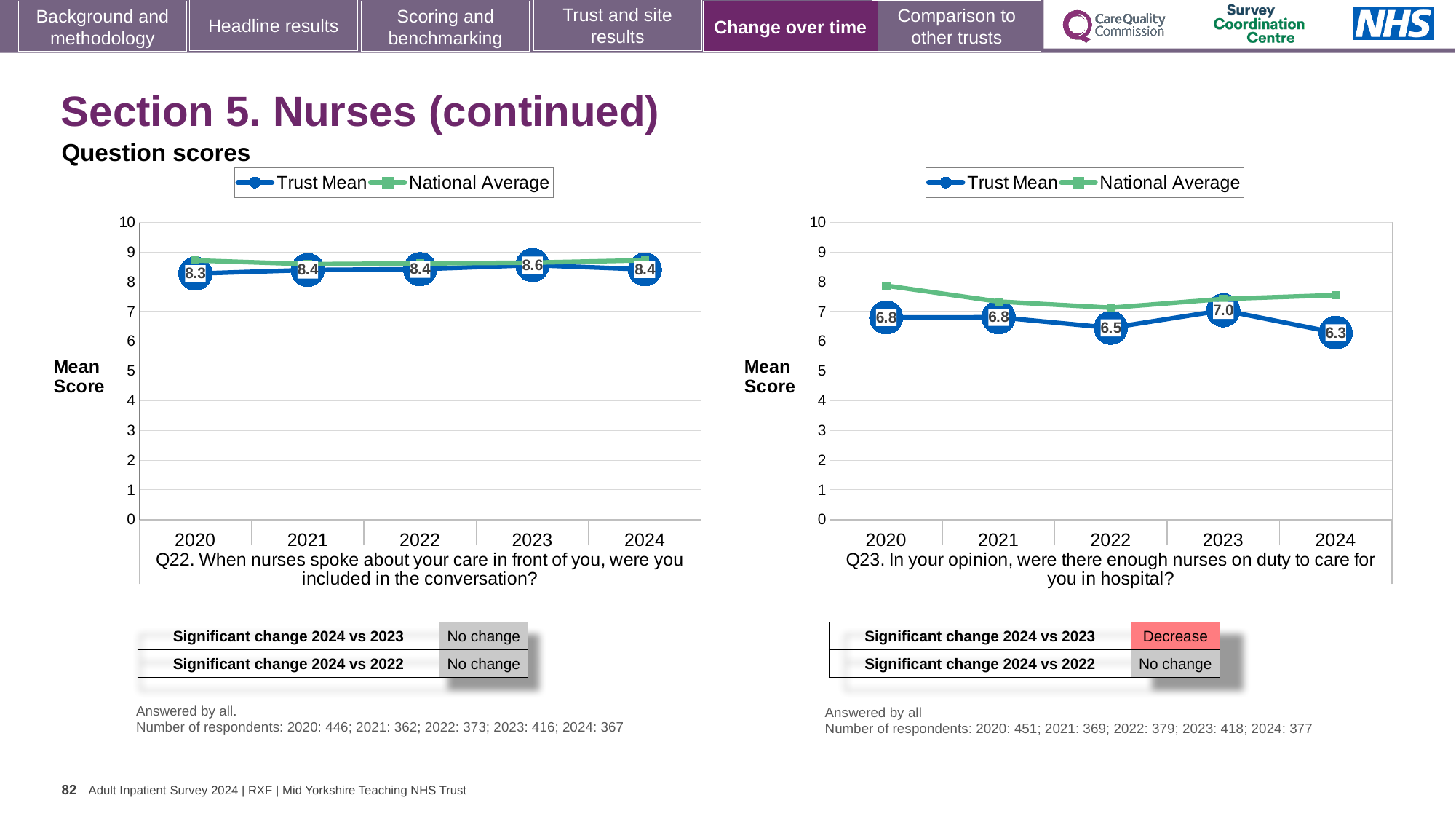
In the Q23 chart (right), which year has the lowest Trust Mean score? 2024 In the Q22 chart (left), what is the Trust Mean score for 2023? 8.6 In the Q23 chart (right), what is the Trust Mean score for 2022? 6.5 In the Q22 chart (left), which year has the highest Trust Mean score? 2023 In the Q22 chart (left), what is the Trust Mean score for 2020? 8.3 In the Q22 chart (left), what is the difference between the Trust Mean scores for 2023 and 2020? 0.3 In the Q23 chart (right), what is the Trust Mean score for 2024? 6.3 How many series does the legend of the Q22 chart (left) list? 2 In the Q23 chart (right), which year has the highest Trust Mean score? 2023 In the Q23 chart (right), what is the difference between the Trust Mean scores for 2023 and 2024? 0.7 How many years are plotted on the x axis of the Q23 chart (right)? 5 In the Q23 chart (right), is the National Average value for 2020 greater or less than 7? greater